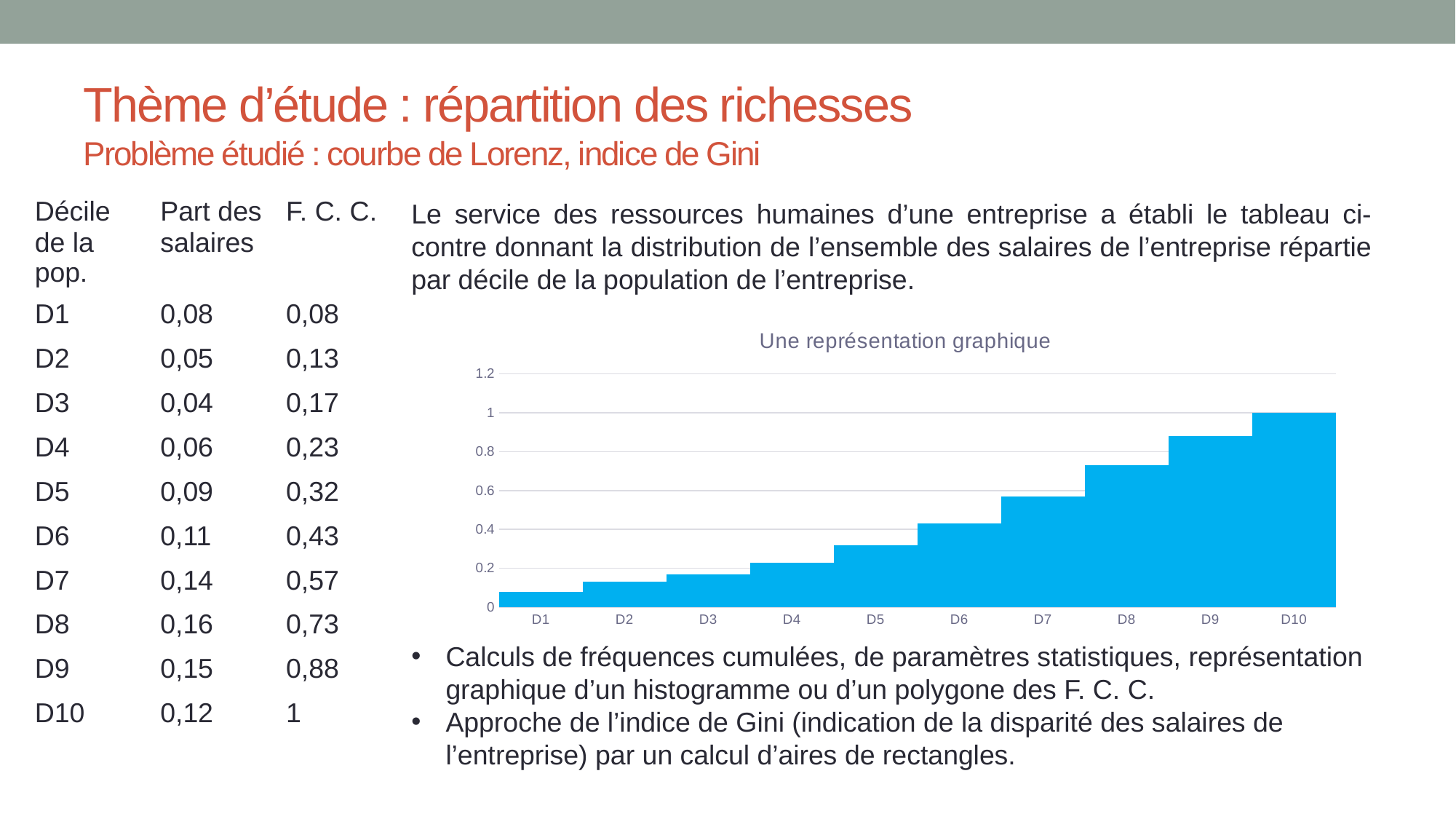
Which decile has the highest bar in the chart? D10 How many deciles (categories) are plotted on the x axis of the chart? 10 What kind of chart is shown under the title "Une représentation graphique"? bar chart What value does the bar for D10 reach on the y axis? 1 Do the bar values rise or fall from D1 to D10? rise Which decile has the lowest bar in the chart? D1 Is the value for D5 greater or less than 0.4? less Which bar is taller, D6 or D4? D6 What is the title of the chart? Une représentation graphique Is the value for D7 greater or less than 0.4? greater Is the value for D3 greater or less than 0.2? less